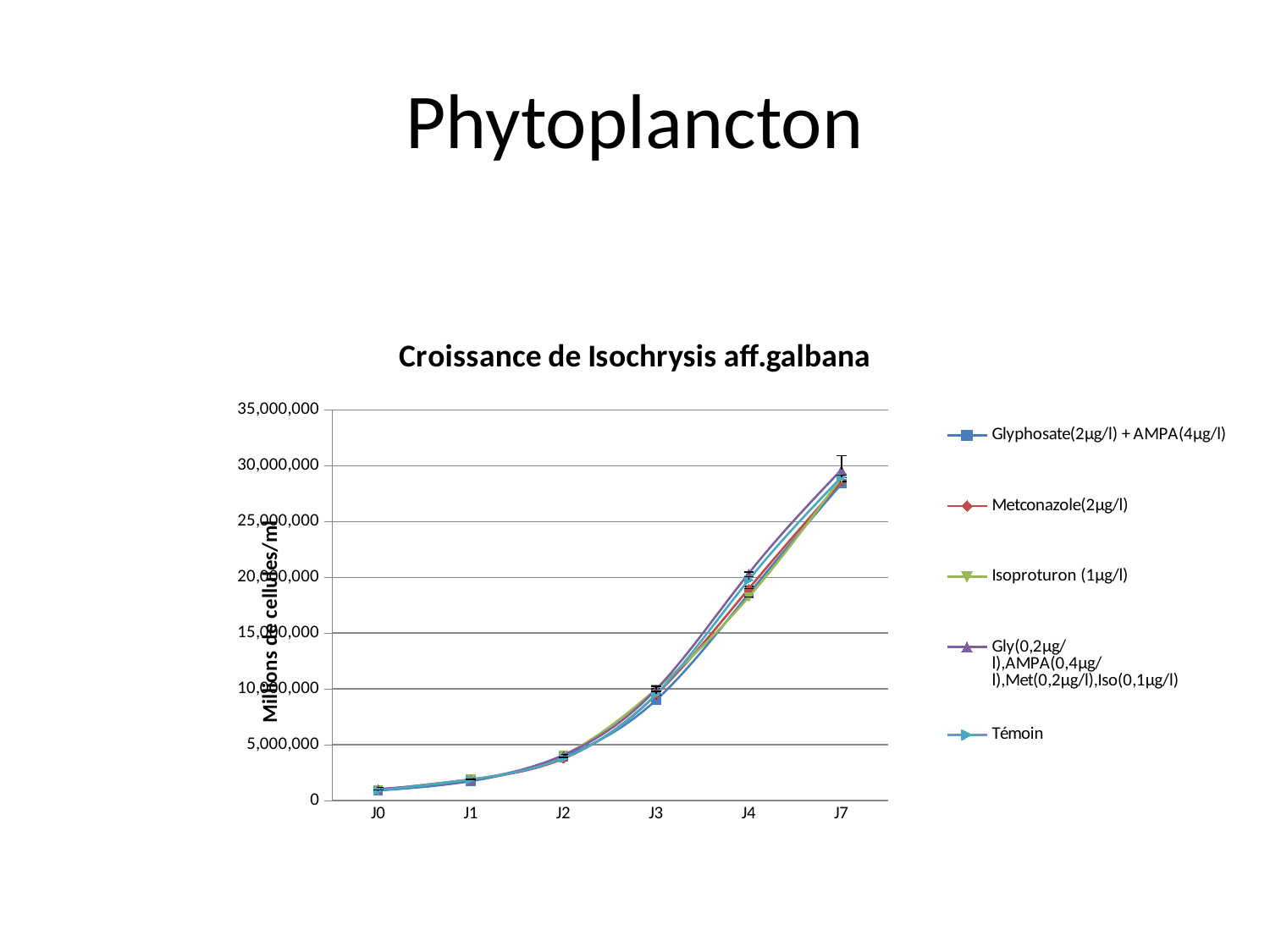
What is the label of the y axis? Millions de cellules/ml Do the values rise or fall from J0 to J7? rise What kind of chart is shown on the slide? line chart How many series does the legend list? 5 Is the value for Glyphosate(2µg/l) + AMPA(4µg/l) at J2 greater or less than 5,000,000? less What is the title of the chart? Croissance de Isochrysis aff.galbana Is the value for Témoin at J7 greater or less than 25,000,000? greater At which day does the Témoin series reach its highest value? J7 Is the value for Témoin at J0 greater or less than 5,000,000? less How many points are there along the x axis? 6